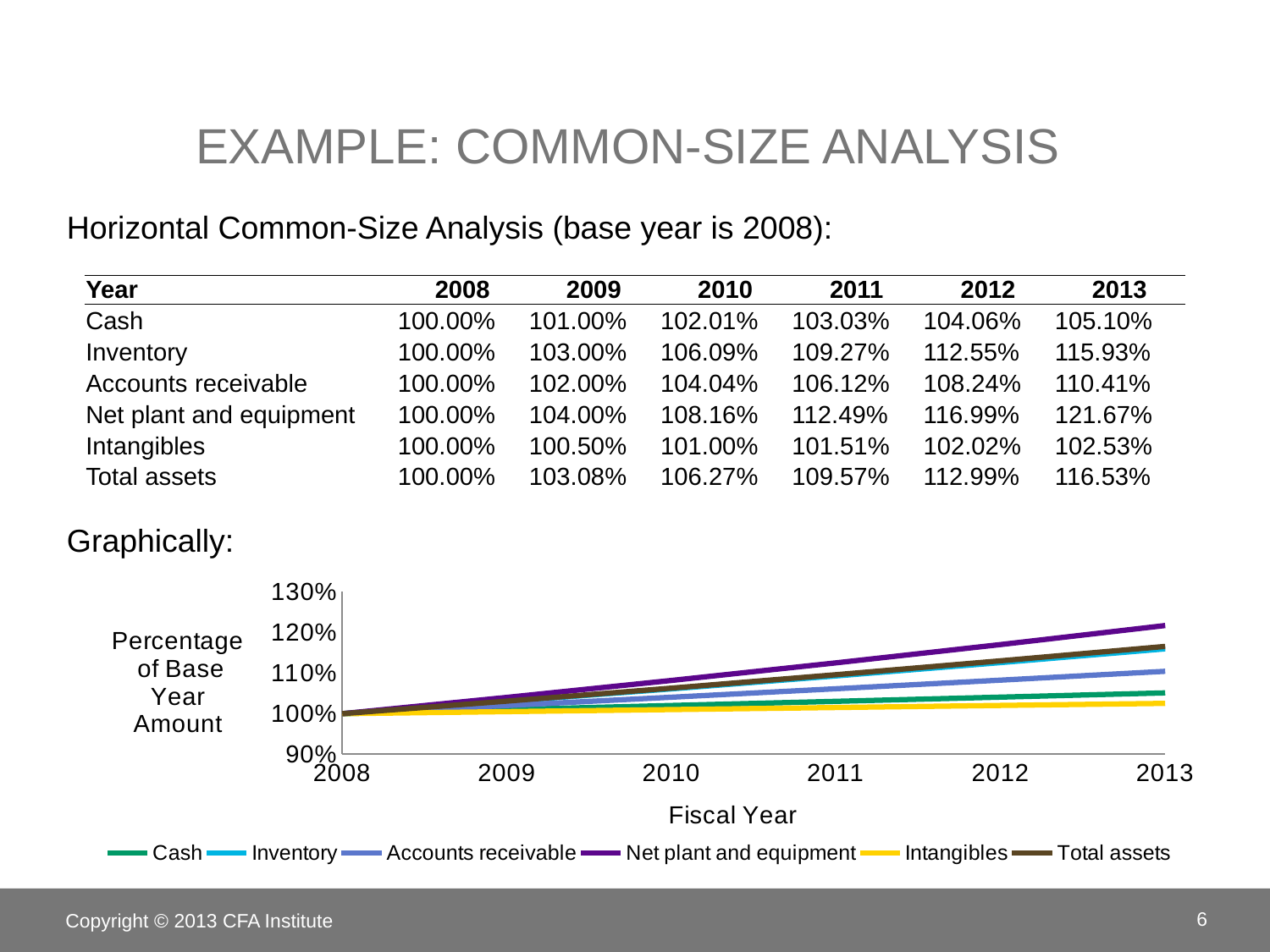
Which series has the lowest value in 2013 on the chart? Intangibles What kind of chart is shown on the slide? Line chart What is the title of the chart's x axis? Fiscal Year Which series has the highest value in 2013 on the chart? Net plant and equipment Which is larger in 2013, Inventory or Accounts receivable? Inventory Is the value for Net plant and equipment in 2013 greater or less than 120%? greater Is the value for Intangibles in 2013 greater or less than 110%? less How many fiscal years are plotted along the x axis of the chart? 6 What is the value for Cash in 2013? 105.10% What is the value for Total assets in 2013? 116.53% How many series does the chart's legend list? 6 Does the Net plant and equipment line rise or fall from 2008 to 2013? Rise